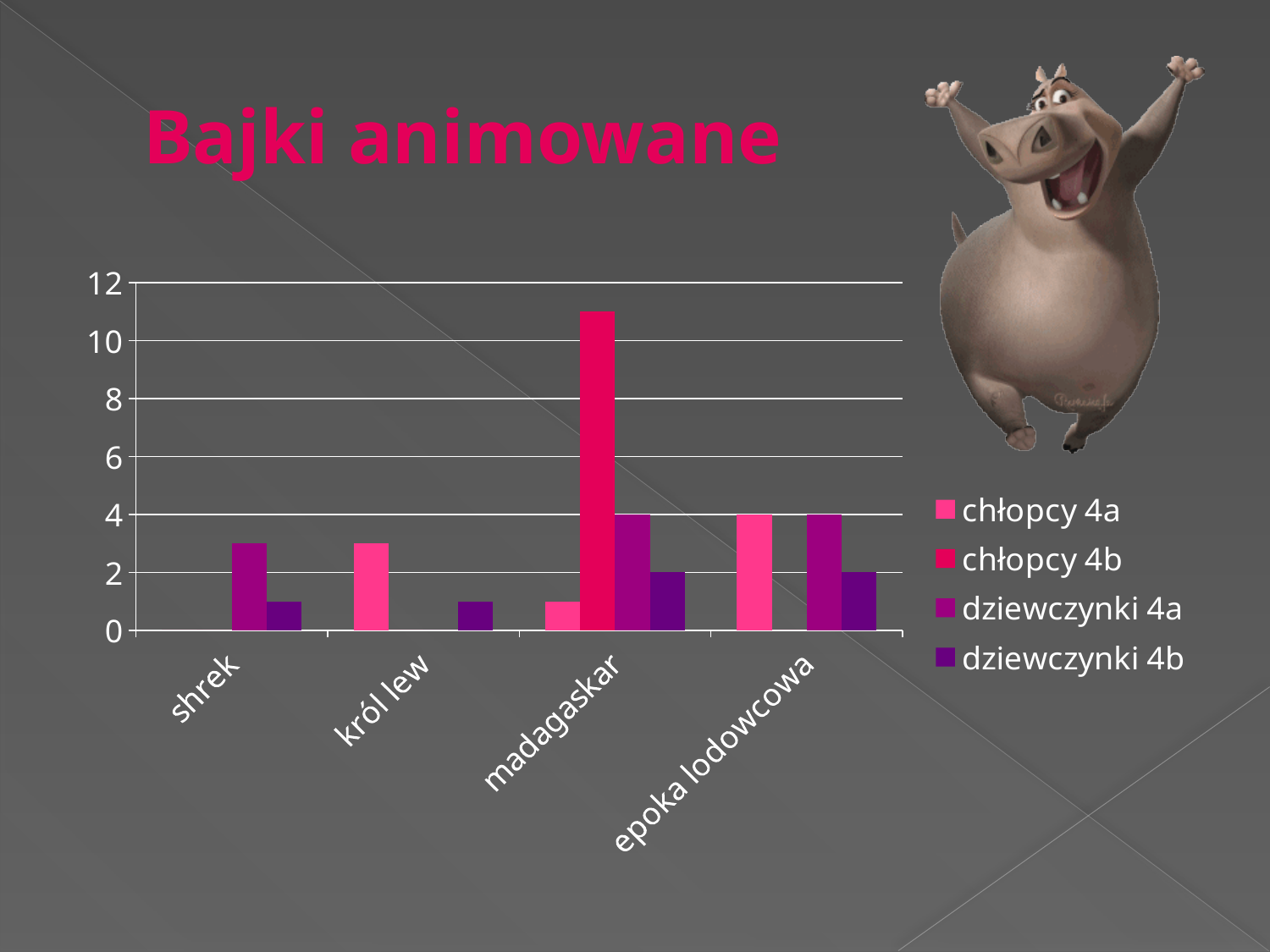
What is the value for dziewczynki 4b at epoka lodowcowa? 2 How many categories are shown on the x axis? 4 What is the value for dziewczynki 4a at madagaskar? 4 Which series has the highest value for madagaskar? chłopcy 4b Is the value for dziewczynki 4a at shrek greater or less than 2? greater What is the title of the slide with the chart? Bajki animowane Which is larger for król lew: chłopcy 4a or dziewczynki 4b? chłopcy 4a What is the value for chłopcy 4a at epoka lodowcowa? 4 What kind of chart is shown on the slide? bar chart How many series does the legend list? 4 Which category has the tallest bar in the chart? madagaskar Is the value for chłopcy 4b at madagaskar greater or less than 10? greater